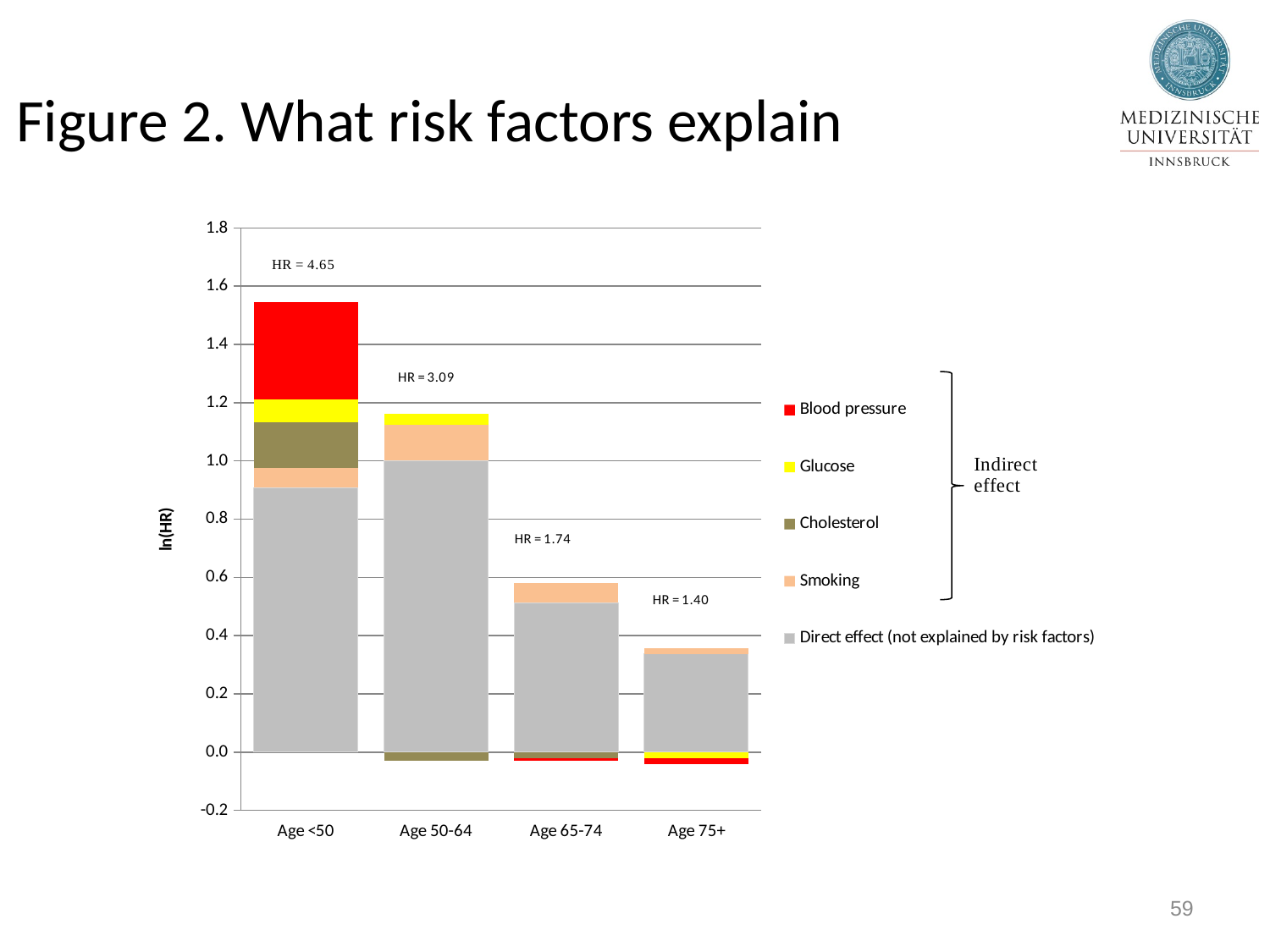
How many age groups are shown on the x axis of the chart? 4 What HR value is annotated for the Age 75+ group? 1.40 How many series does the chart's legend list? 5 Is the top of the stacked bar for Age <50 greater or less than 1.4 on the ln(HR) axis? greater Do the annotated HR values rise or fall as age increases along the x axis? fall What is the difference between the annotated HR for Age <50 and the annotated HR for Age 50-64? 1.56 Which has the larger annotated HR, Age 50-64 or Age 65-74? Age 50-64 What kind of chart is shown on the slide? bar chart What HR value is annotated above the bar for Age <50? 4.65 Which age group has the tallest stacked bar? Age <50 Is the top of the stacked bar for Age 75+ greater or less than 0.4 on the ln(HR) axis? less Which age group has the shortest stacked bar? Age 75+